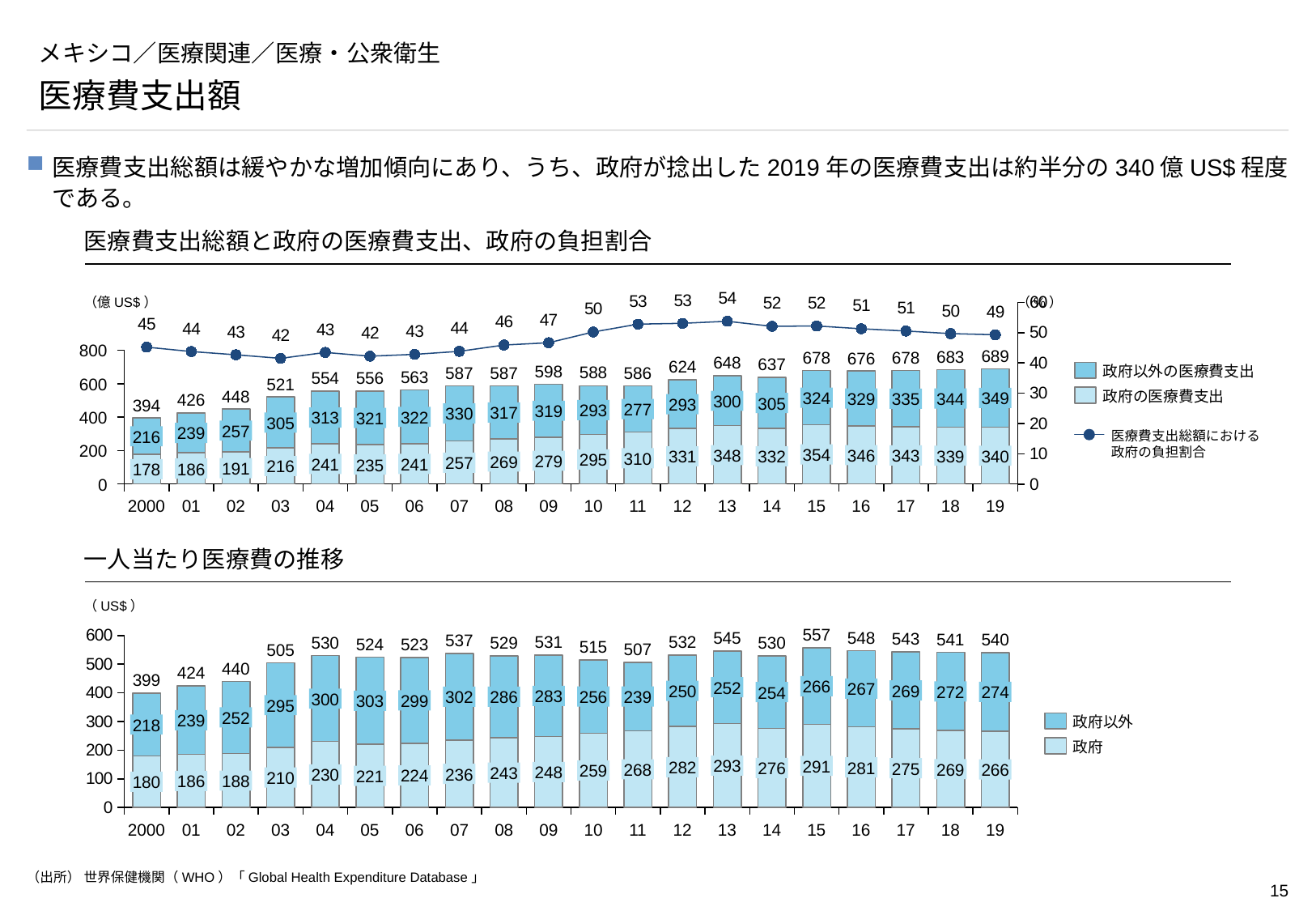
In the top chart (医療費支出総額と政府の医療費支出、政府の負担割合), what is the value of 政府の医療費支出 for 19? 340 In the top chart, what is the difference between 政府以外の医療費支出 in 19 and in 2000? 133 What kind of chart is the bottom chart (一人当たり医療費の推移)? Stacked bar chart In the bottom chart, for 19, which is larger: 政府 or 政府以外? 政府以外 In the top chart, in which year does the 医療費支出総額における政府の負担割合 line reach its highest value? 13 In the bottom chart (一人当たり医療費の推移), what is the 政府 value for 13? 293 In the bottom chart, which year has the lowest total per-capita medical expenditure? 2000 In the bottom chart, which year has the highest total per-capita medical expenditure? 15 In the top chart, what is the total medical expenditure (stacked bar total) for 13? 648 In the top chart, how many years are shown on the x axis? 20 In the top chart, how many series does the legend list? 3 In the top chart, does the 政府の負担割合 line rise or fall from 2000 to 03? Fall